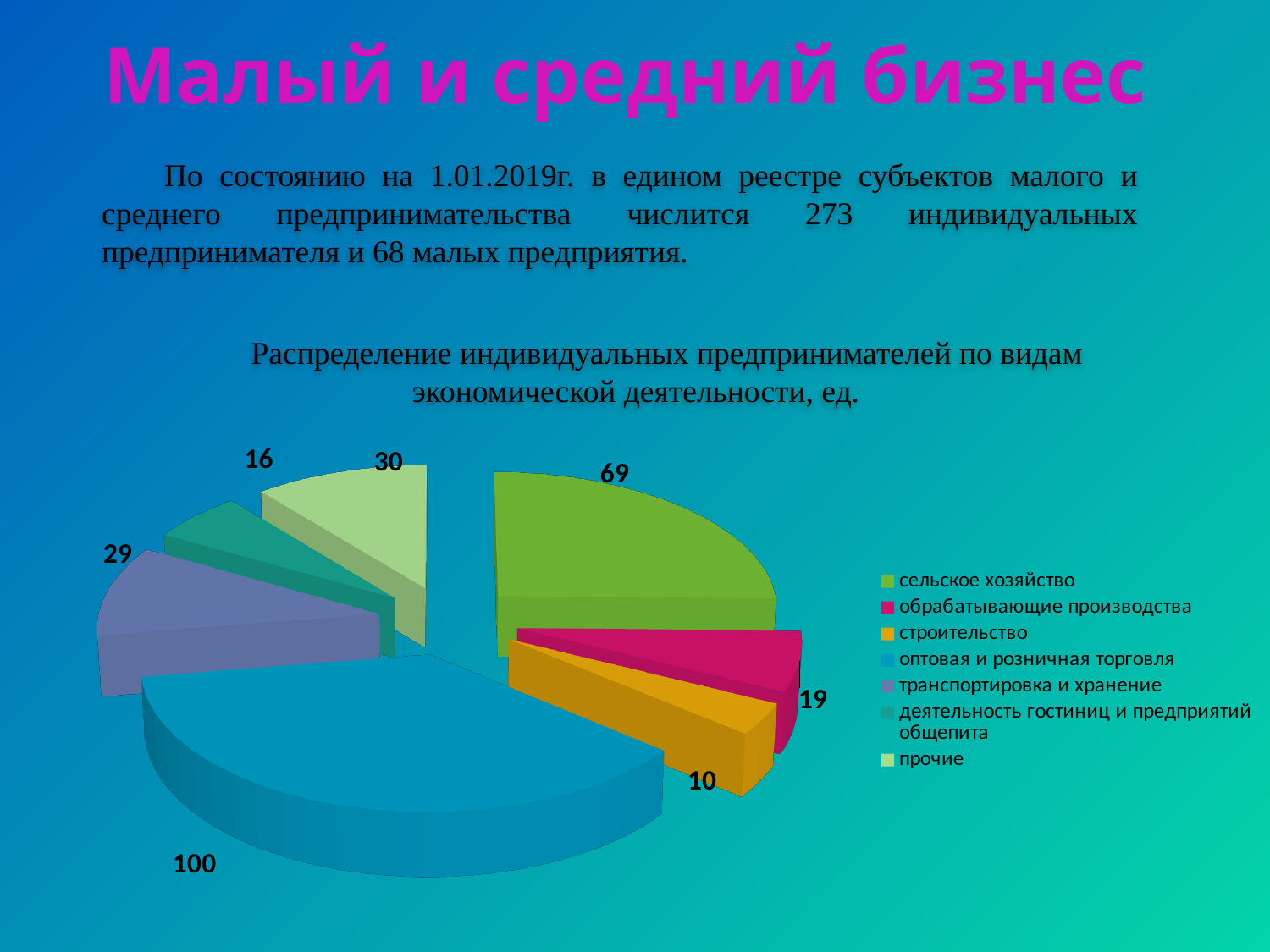
Which category has the smallest slice? строительство How many categories does the pie chart have? 7 Which category has the largest slice? оптовая и розничная торговля What is the total of all slices in the pie chart? 273 What is the title of the chart? Распределение индивидуальных предпринимателей по видам экономической деятельности, ед. What is the value for строительство? 10 What is the value for сельское хозяйство? 69 Which is larger, the value for обрабатывающие производства or the value for деятельность гостиниц и предприятий общепита? обрабатывающие производства What is the value for транспортировка и хранение? 29 What kind of chart is shown on the slide? pie chart What is the difference between the values for оптовая и розничная торговля and сельское хозяйство? 31 What is the value for оптовая и розничная торговля? 100